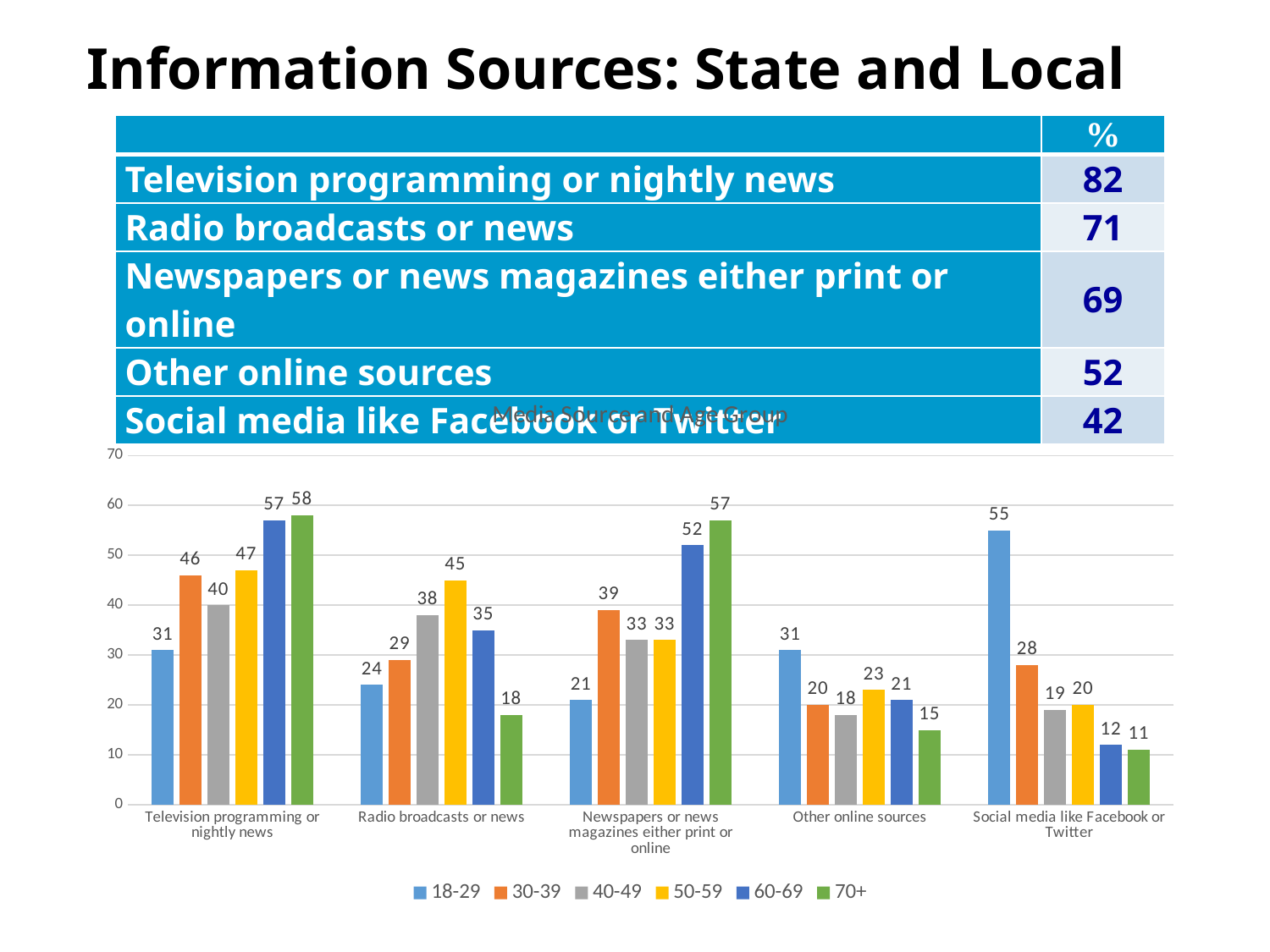
In the bar chart, what is the value for the 70+ group for Television programming or nightly news? 58 In the bar chart, what is the value for the 18-29 group for Social media like Facebook or Twitter? 55 In the bar chart, what is the value for the 50-59 group for Radio broadcasts or news? 45 In the bar chart, which is larger for Radio broadcasts or news: the 40-49 value or the 60-69 value? 40-49 How many series does the legend of the bar chart list? 6 In the bar chart, which age group has the highest value for Newspapers or news magazines either print or online? 70+ What kind of chart is shown on the slide? bar chart In the bar chart, which age group is shown in green in the legend? 70+ How many media source categories are shown on the x axis of the bar chart? 5 In the bar chart, what is the difference between the 18-29 and 70+ values for Social media like Facebook or Twitter? 44 In the bar chart, which age group has the lowest value for Other online sources? 70+ In the bar chart, is the 60-69 value for Newspapers or news magazines either print or online greater or less than 40? greater